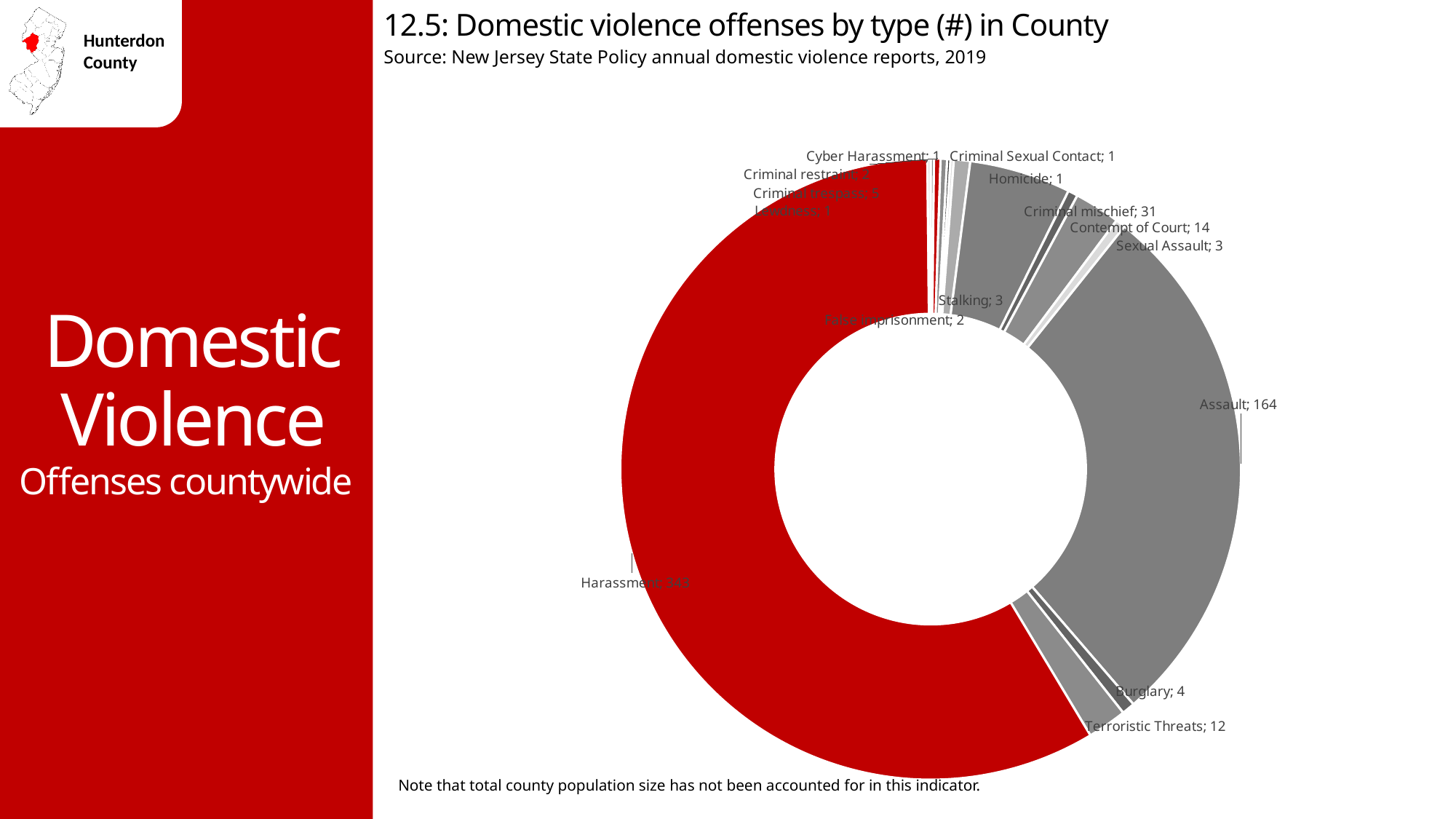
What is the value for Terroristic Threats? 12 What colour is the Harassment slice? Red What is the value for Burglary? 4 What is the value for Contempt of Court? 14 What type of chart is shown on the slide? Pie (donut) chart Which is larger, Criminal mischief or Contempt of Court? Criminal mischief What is the difference between the Harassment and Assault values? 179 How many offense types (slices) are shown in the chart? 15 What is the value for Harassment? 343 What is the value for Criminal mischief? 31 How many domestic violence offenses of type Assault are shown? 164 Which offense type has the highest number of offenses? Harassment